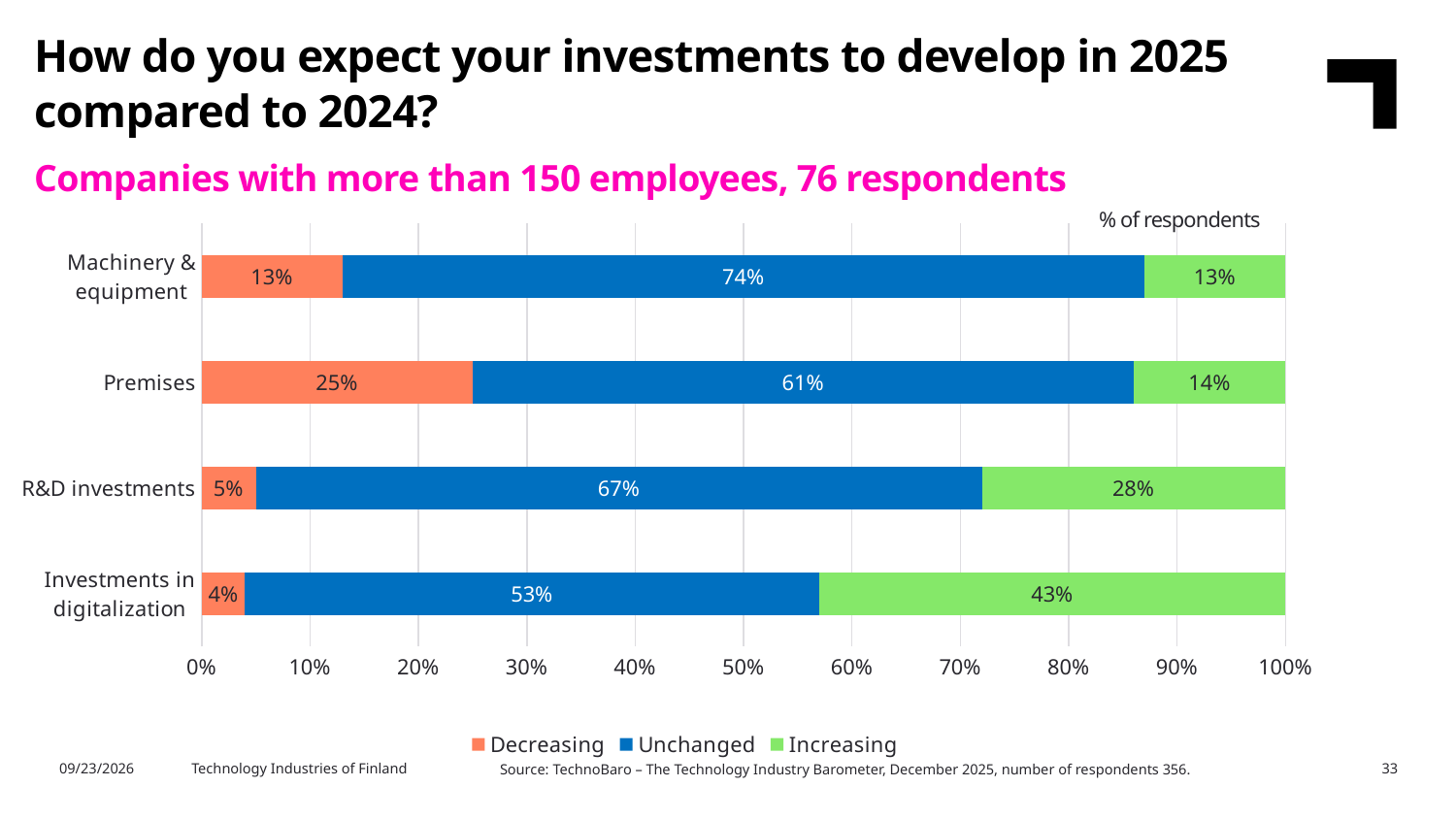
What percentage of respondents expect Premises investments to be decreasing? 25% Which colour represents the Increasing series in the chart? Green Which category has the lowest share of respondents expecting a decrease? Investments in digitalization Which category has the highest share of respondents expecting an increase? Investments in digitalization How many series does the legend list? 3 How many investment categories are shown in the chart? 4 What percentage of respondents expect R&D investments to be increasing? 28% What percentage of respondents expect Investments in digitalization to be unchanged? 53% Is the Unchanged value for R&D investments greater or less than 60%? greater Which is larger: the Unchanged share for Machinery & equipment or for Premises? Machinery & equipment What kind of chart is shown on the slide? Stacked bar chart What is the difference between the Increasing share for Investments in digitalization and for R&D investments? 15%